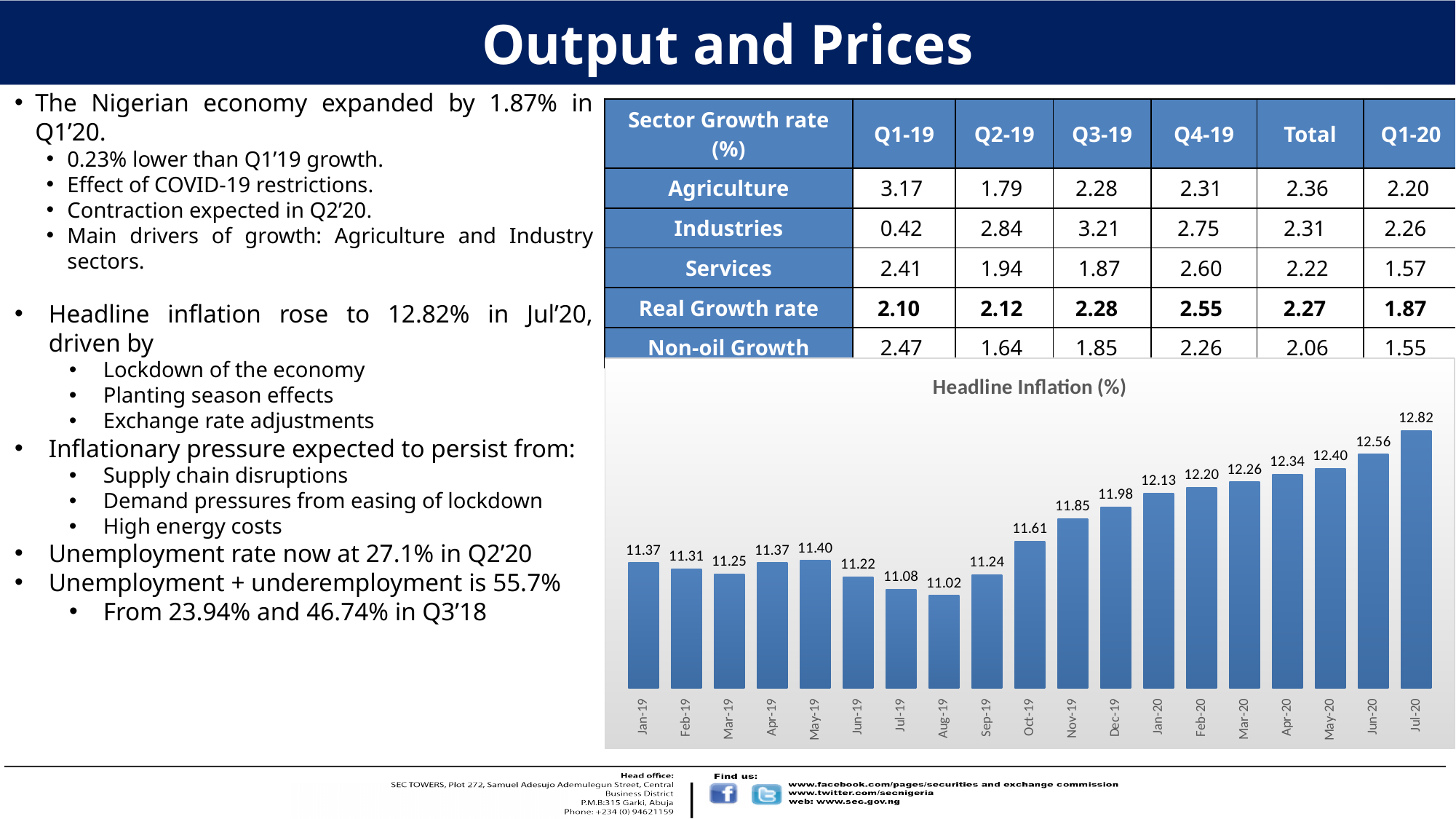
What is the headline inflation value for Jul-20? 12.82 What is the headline inflation value for Jan-20? 12.13 Which month has the highest headline inflation in the chart? Jul-20 How many months are plotted in the Headline Inflation chart? 19 Which month has the lowest headline inflation in the chart? Aug-19 What is the title of the chart on the slide? Headline Inflation (%) What is the headline inflation value for Aug-19? 11.02 Do the headline inflation values rise or fall from Aug-19 to Jul-20? Rise What kind of chart is used to show headline inflation? Bar chart Which is larger, the headline inflation for May-19 or for Jun-19? May-19 What is the difference between the headline inflation values for Jul-20 and Jan-19? 1.45 What is the difference between the headline inflation values for Dec-19 and Nov-19? 0.13